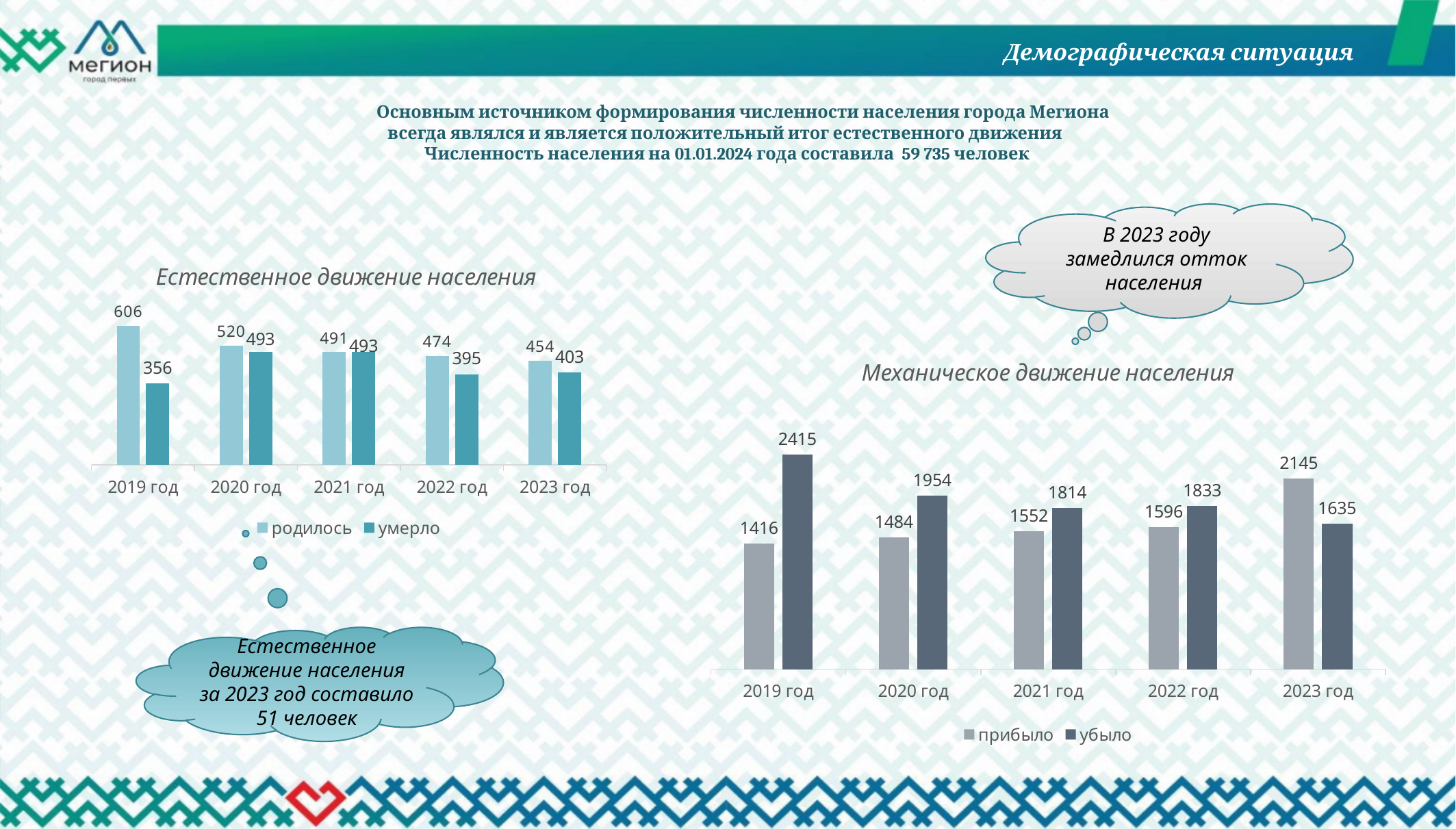
In the chart 'Естественное движение населения', what is the value for 'родилось' in 2019 год? 606 In the chart 'Естественное движение населения', how many series does the legend list? 2 In the chart 'Естественное движение населения', does the value for 'родилось' rise or fall from 2019 год to 2023 год? fall In the chart 'Механическое движение населения', what is the value for 'прибыло' in 2023 год? 2145 In the chart 'Механическое движение населения', what is the value for 'убыло' in 2019 год? 2415 In the chart 'Естественное движение населения', which year has the highest value for 'родилось'? 2019 год What kind of chart is 'Механическое движение населения'? bar chart In the chart 'Механическое движение населения', which is larger in 2022 год: 'прибыло' or 'убыло'? убыло In the chart 'Естественное движение населения', what is the value for 'умерло' in 2022 год? 395 In the chart 'Механическое движение населения', which year has the lowest value for 'прибыло'? 2019 год In the chart 'Механическое движение населения', what is the difference between 'убыло' and 'прибыло' in 2020 год? 470 In the chart 'Естественное движение населения', what is the difference between 'родилось' and 'умерло' in 2023 год? 51